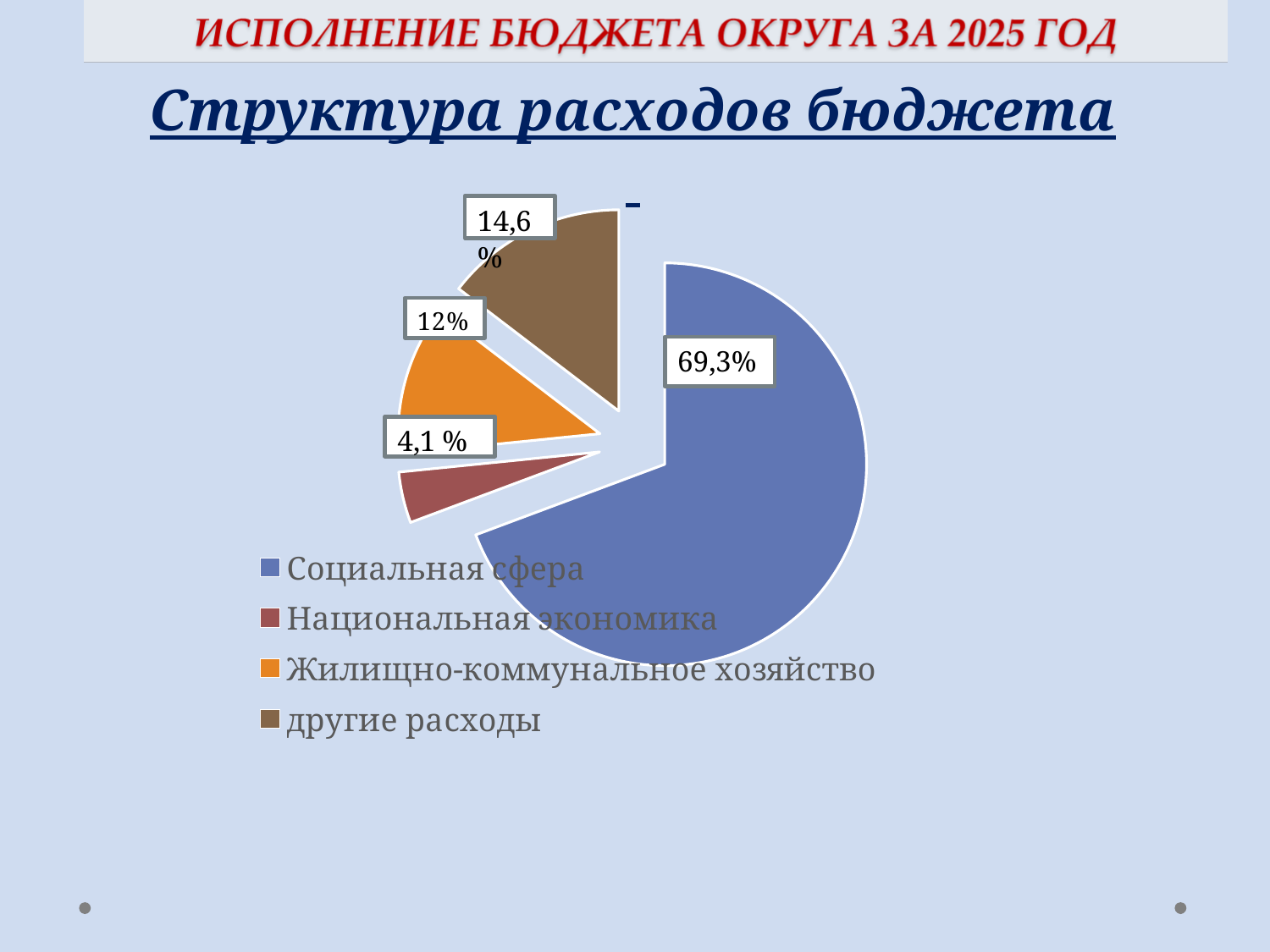
What share of budget expenditure is Социальная сфера? 69,3% What share of budget expenditure is другие расходы? 14,6 % Which category has the smallest share of the pie? Национальная экономика What is the title of the chart on the slide? Структура расходов бюджета What colour is the slice for Жилищно-коммунальное хозяйство? orange What share of budget expenditure is Национальная экономика? 4,1 % What is the difference in percentage points between Социальная сфера and другие расходы? 54,7 What share of budget expenditure is Жилищно-коммунальное хозяйство? 12% Which category has the largest share of the pie? Социальная сфера What kind of chart is shown on the slide? pie chart Which is larger, the share for другие расходы or the share for Жилищно-коммунальное хозяйство? другие расходы How many categories does the pie chart show? 4